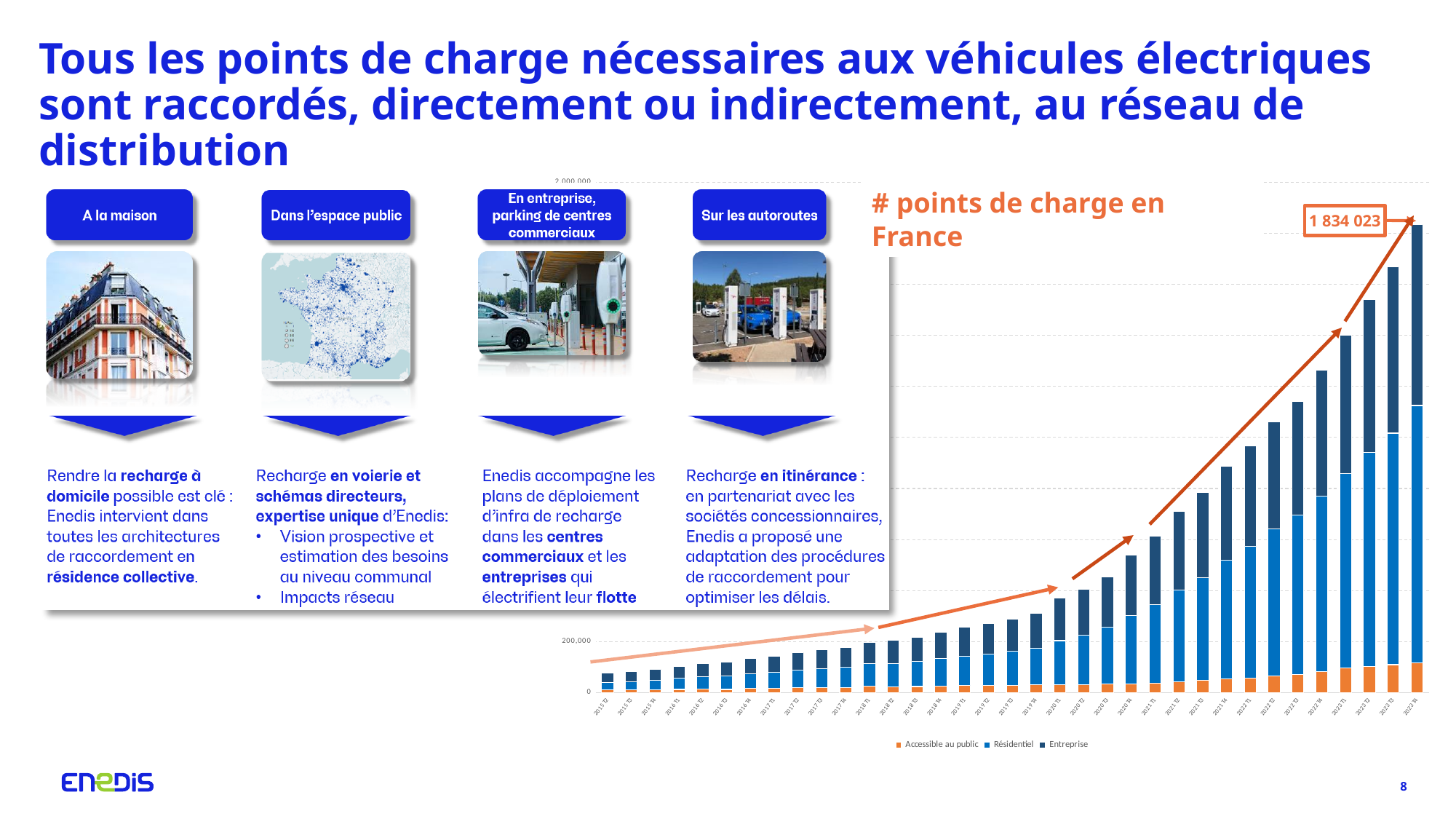
What kind of chart is shown on the right of the slide? bar chart Which quarter has the highest total number of charging points? 2023 T4 What is the title of the chart? # points de charge en France Do the bar totals rise or fall from 2015 T2 to 2023 T4? rise Is the total for 2015 T2 greater or less than 200,000? less How many series does the legend of the chart list? 3 Which quarter has the lowest total number of charging points? 2015 T2 What total value is labelled for the last bar (2023 T4) in the chart? 1 834 023 Is the total for 2019 T4 greater or less than 400,000? less Is the total for 2023 T4 greater or less than 1,000,000? greater In the 2023 T4 bar, which segment is larger: Entreprise or Accessible au public? Entreprise What are the three series listed in the chart legend? Accessible au public, Résidentiel, Entreprise